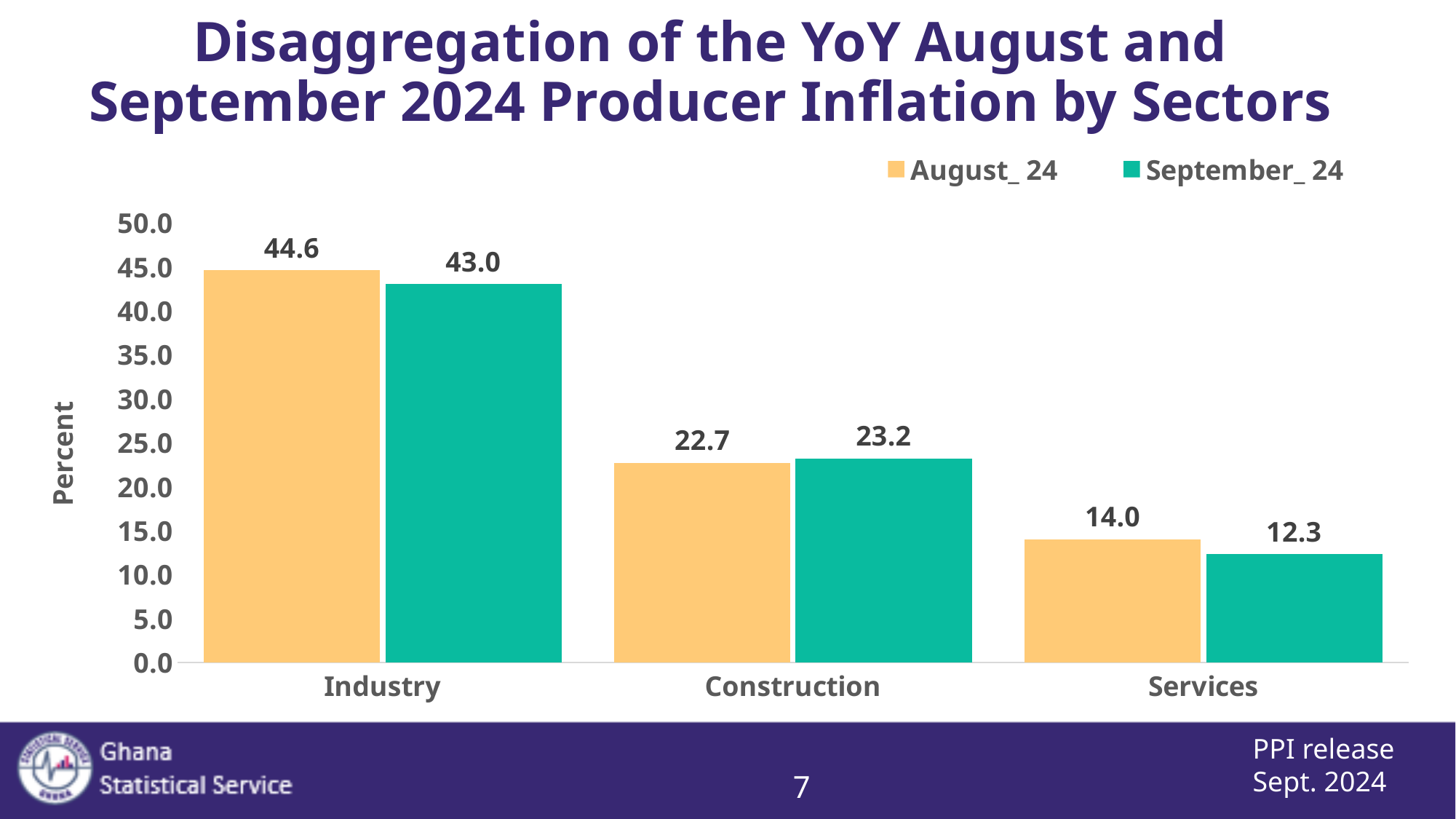
How many series does the legend list? 2 Is the August_ 24 value for Construction greater or less than 25.0? less What is the September_ 24 value for Services? 12.3 What kind of chart is shown on the slide? Bar chart For Construction, which is larger: the August_ 24 value or the September_ 24 value? September_ 24 How many sectors are shown on the x axis? 3 What is the September_ 24 value for Construction? 23.2 What is the difference between the August_ 24 and September_ 24 values for Services? 1.7 Which sector has the lowest August_ 24 value? Services Which sector has the highest September_ 24 value? Industry What is the difference between the August_ 24 and September_ 24 values for Industry? 1.6 What is the August_ 24 value for Industry? 44.6